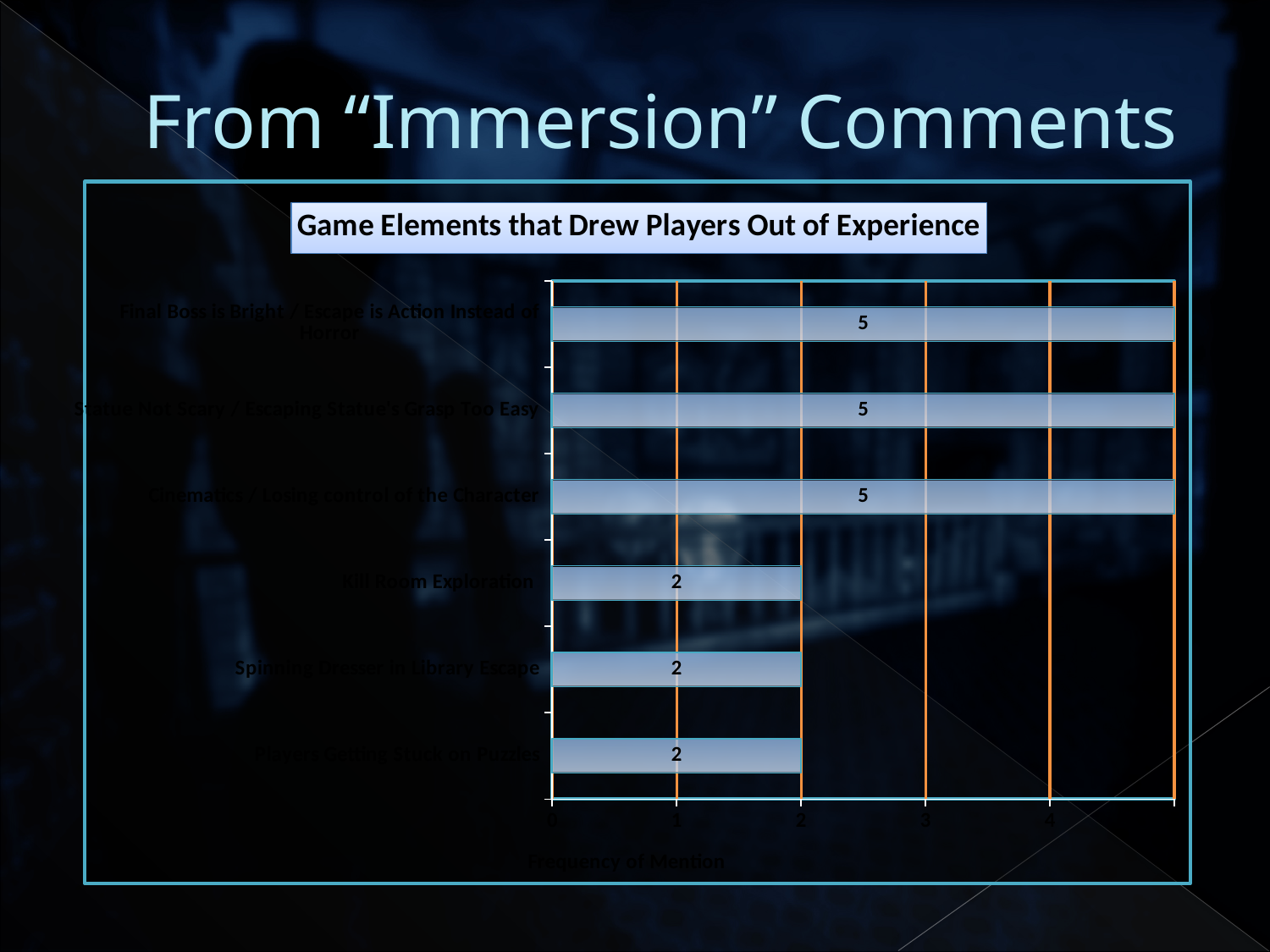
What is the value for "Statue Not Scary / Escaping Statue's Grasp Too Easy"? 5 What kind of chart is shown on the slide? Bar chart Is the value for "Spinning Dresser in Library Escape" greater or less than 3? less What is the highest value shown in the chart? 5 What is the value for "Kill Room Exploration"? 2 What is the value for "Players Getting Stuck on Puzzles"? 2 What is the value for "Cinematics / Losing control of the Character"? 5 Which is larger, the value for "Cinematics / Losing control of the Character" or the value for "Kill Room Exploration"? Cinematics / Losing control of the Character What is the label of the horizontal axis? Frequency of Mention What is the title of the chart? Game Elements that Drew Players Out of Experience What is the difference between the value for "Final Boss is Bright / Escape is Action Instead of Horror" and the value for "Spinning Dresser in Library Escape"? 3 How many categories are plotted in the chart? 6